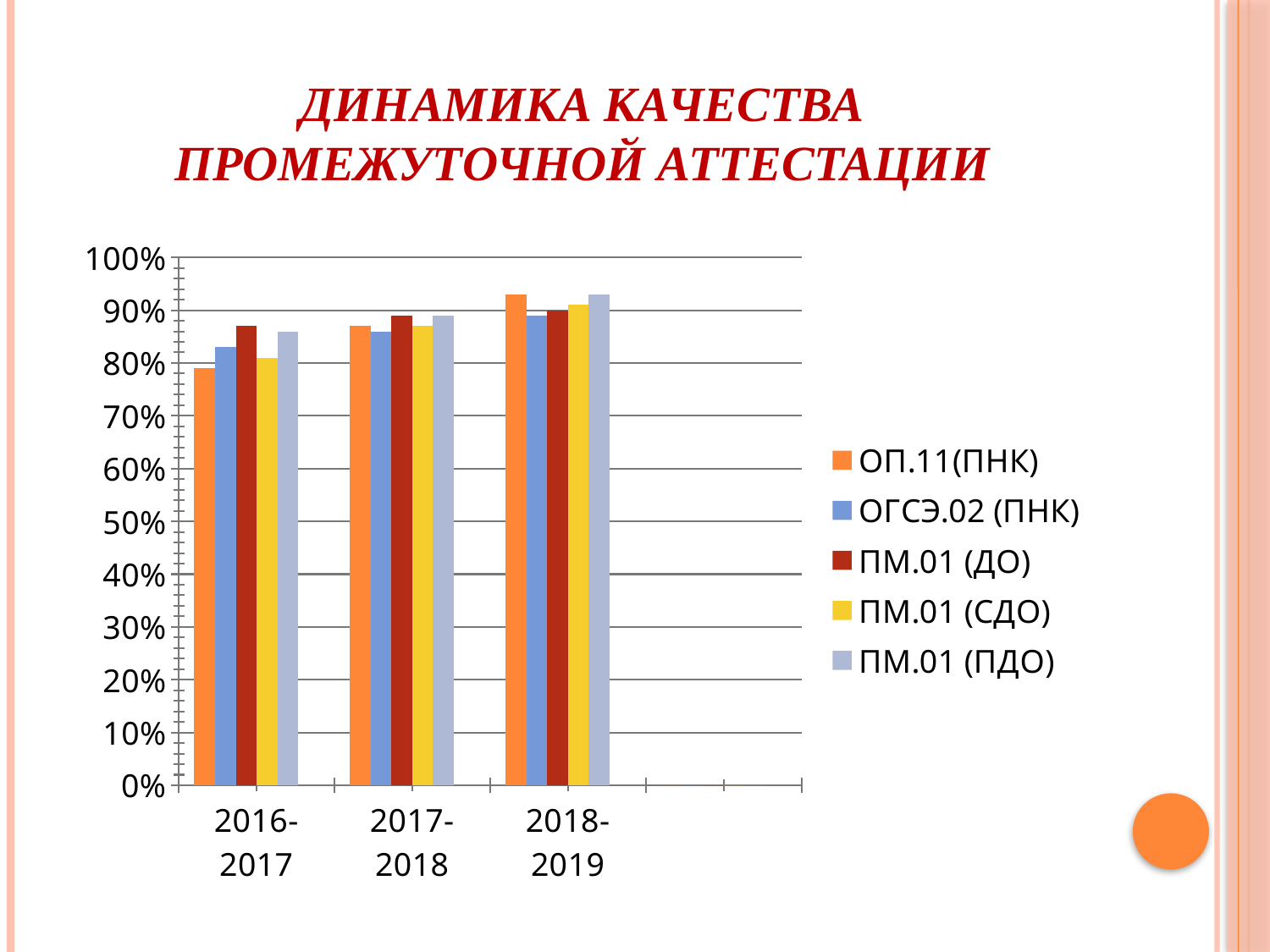
Does the value for ОГСЭ.02 (ПНК) rise or fall across the three academic years? rise In 2016-2017, which is larger: the value for ОП.11(ПНК) or the value for ПМ.01 (ДО)? ПМ.01 (ДО) Does the value for ОП.11(ПНК) rise or fall from 2016-2017 to 2018-2019? rise How many academic years are shown on the x axis of the chart? 3 How many series does the chart legend list? 5 Is the value for ПМ.01 (СДО) in 2016-2017 greater or less than 90%? less Which is larger for ОП.11(ПНК): the value in 2016-2017 or the value in 2018-2019? 2018-2019 What is the title of the chart on the slide? ДИНАМИКА КАЧЕСТВА ПРОМЕЖУТОЧНОЙ АТТЕСТАЦИИ What kind of chart is shown on the slide? bar chart Is the value for ОП.11(ПНК) in 2018-2019 greater or less than 90%? greater Is the value for ОП.11(ПНК) in 2016-2017 greater or less than 70%? greater